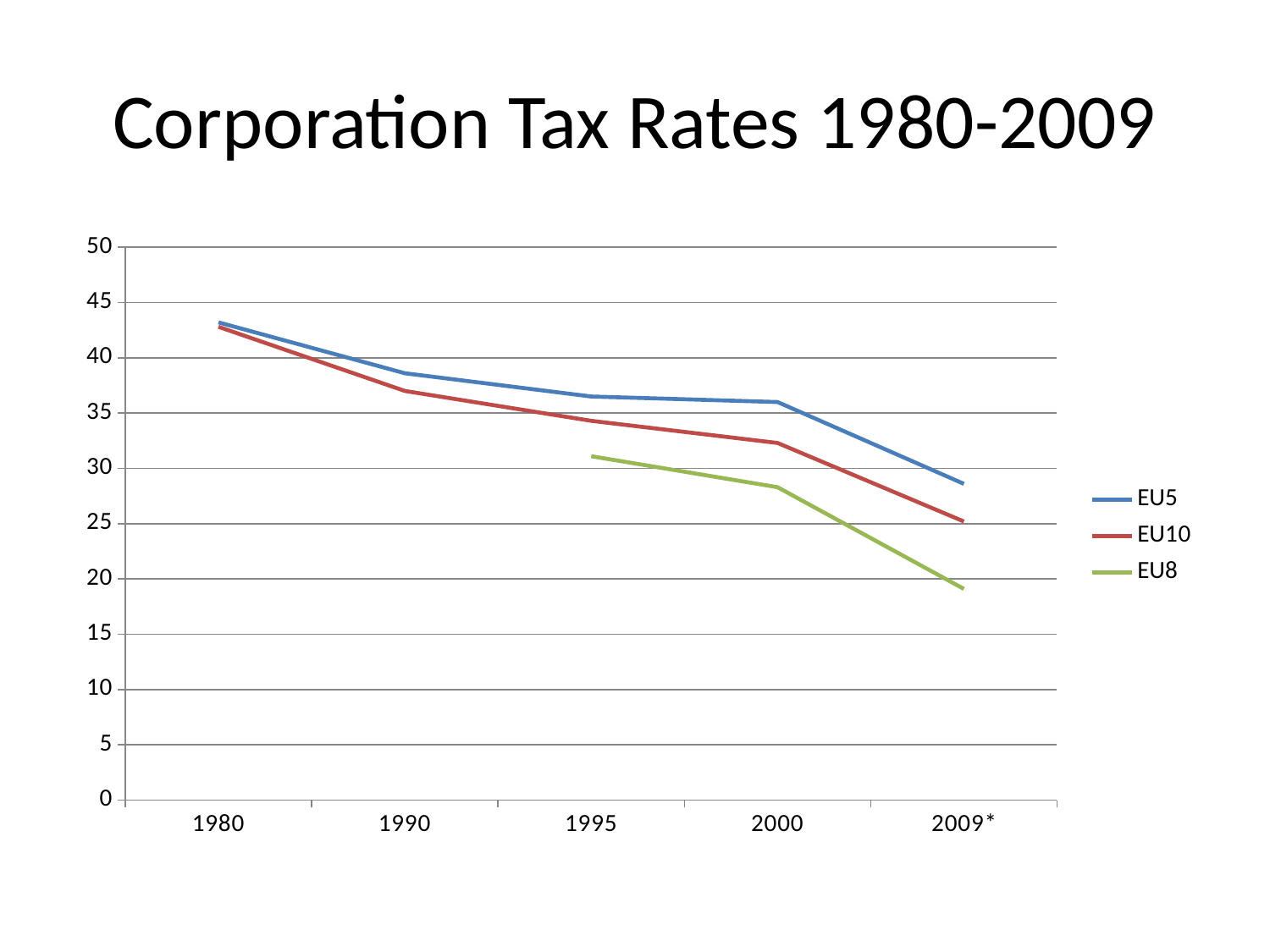
Does the EU5 line rise or fall from 1980 to 2009*? fall Is the value for EU8 in 2000 greater or less than 30? less Which series has the lowest value in 2009*? EU8 In 2000, which is larger, the value for EU10 or the value for EU8? EU10 Is the value for EU10 in 2000 greater or less than 30? greater Which series has the highest value in 2009*? EU5 How many series does the legend list? 3 What kind of chart is shown on the slide? line chart What is the title of the chart? Corporation Tax Rates 1980-2009 Is the value for EU5 in 1980 greater or less than 40? greater How many year categories are shown on the x axis? 5